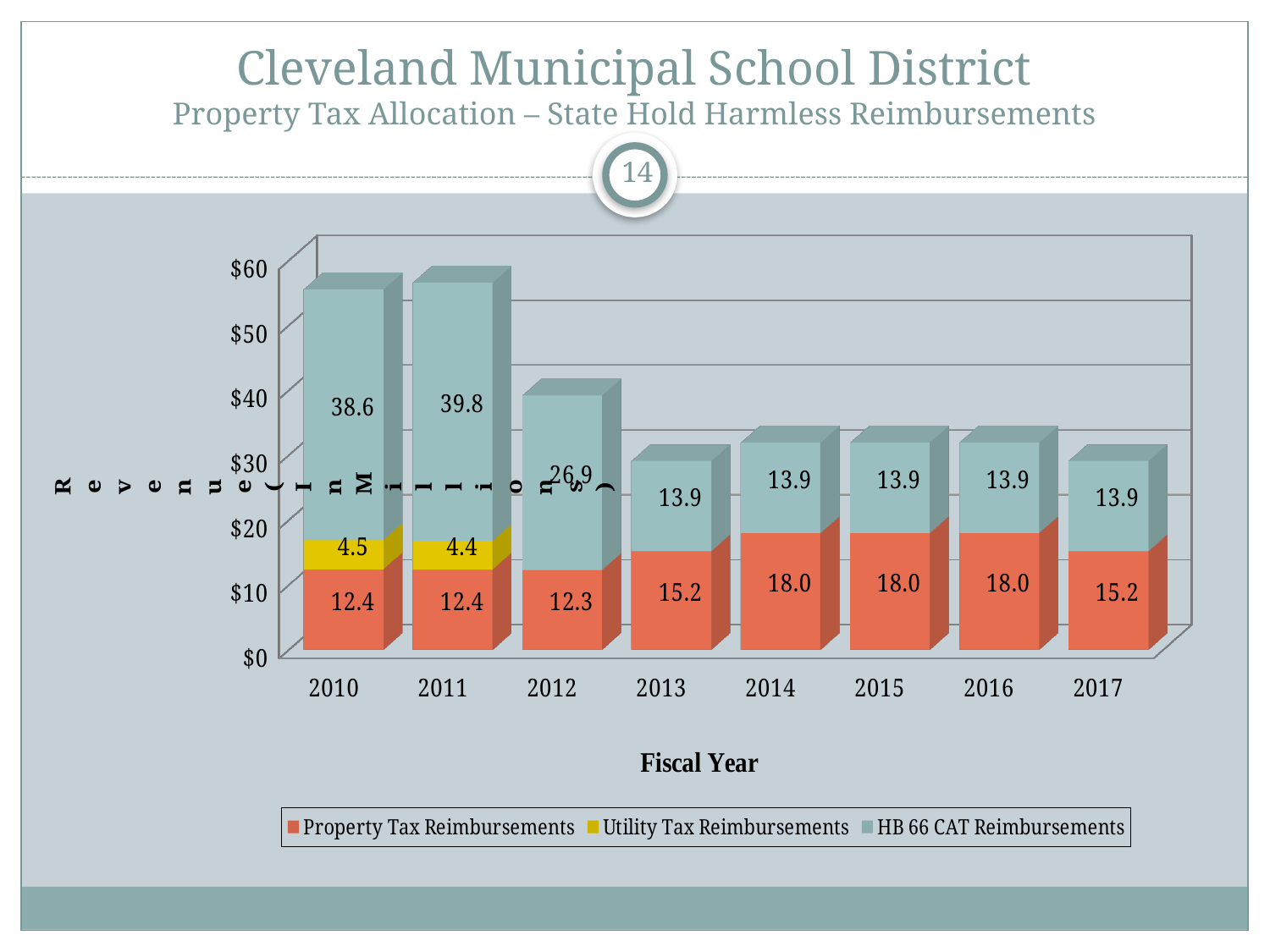
What is the total of the stacked bar for 2013? 29.1 What is the value of Utility Tax Reimbursements for 2010? 4.5 How many series does the legend list? 3 Which year has larger Property Tax Reimbursements, 2013 or 2014? 2014 What kind of chart is shown on the slide? Stacked bar chart Which fiscal year has the lowest Property Tax Reimbursements? 2012 What is the value of HB 66 CAT Reimbursements for 2011? 39.8 Do HB 66 CAT Reimbursements rise or fall from 2011 to 2013? Fall What is the difference between HB 66 CAT Reimbursements in 2011 and 2010? 1.2 How many fiscal years are shown on the x axis? 8 Which fiscal year has the highest HB 66 CAT Reimbursements? 2011 What is the value of Property Tax Reimbursements for 2014? 18.0